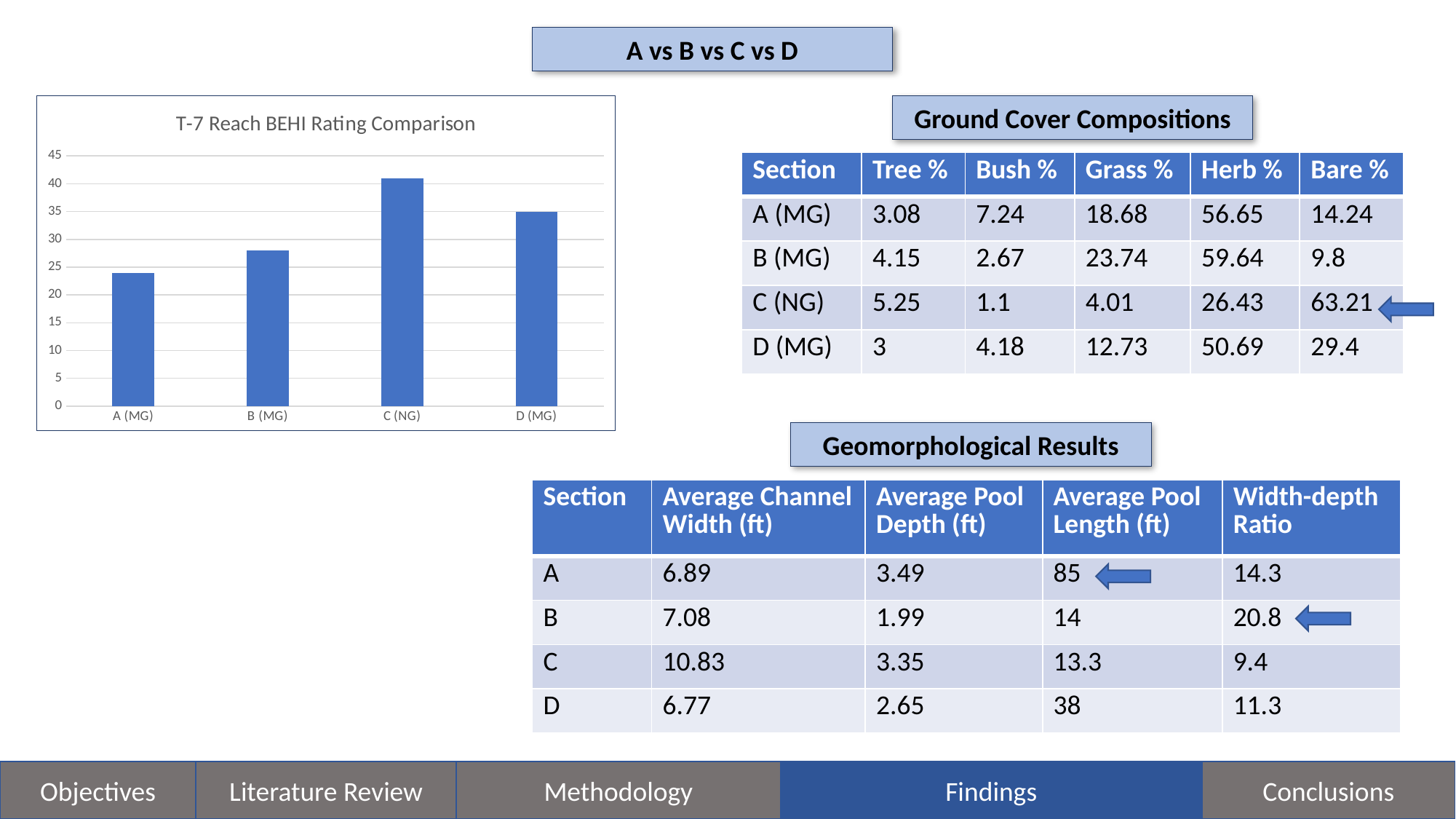
What kind of chart is the T-7 Reach BEHI Rating Comparison? bar chart How many sections are plotted in the T-7 Reach BEHI Rating Comparison chart? 4 In the T-7 Reach BEHI Rating Comparison chart, is the value for B (MG) greater or less than 25? greater Which section has the highest BEHI rating in the T-7 Reach BEHI Rating Comparison chart? C (NG) In the T-7 Reach BEHI Rating Comparison chart, is the value for D (MG) greater or less than 30? greater In the T-7 Reach BEHI Rating Comparison chart, is the value for A (MG) greater or less than 25? less In the T-7 Reach BEHI Rating Comparison chart, which has a higher BEHI rating, B (MG) or D (MG)? D (MG) What is the highest value shown on the vertical axis of the T-7 Reach BEHI Rating Comparison chart? 45 What is the title of the bar chart on the slide? T-7 Reach BEHI Rating Comparison Which section has the lowest BEHI rating in the T-7 Reach BEHI Rating Comparison chart? A (MG) In the T-7 Reach BEHI Rating Comparison chart, which has a higher BEHI rating, A (MG) or C (NG)? C (NG)